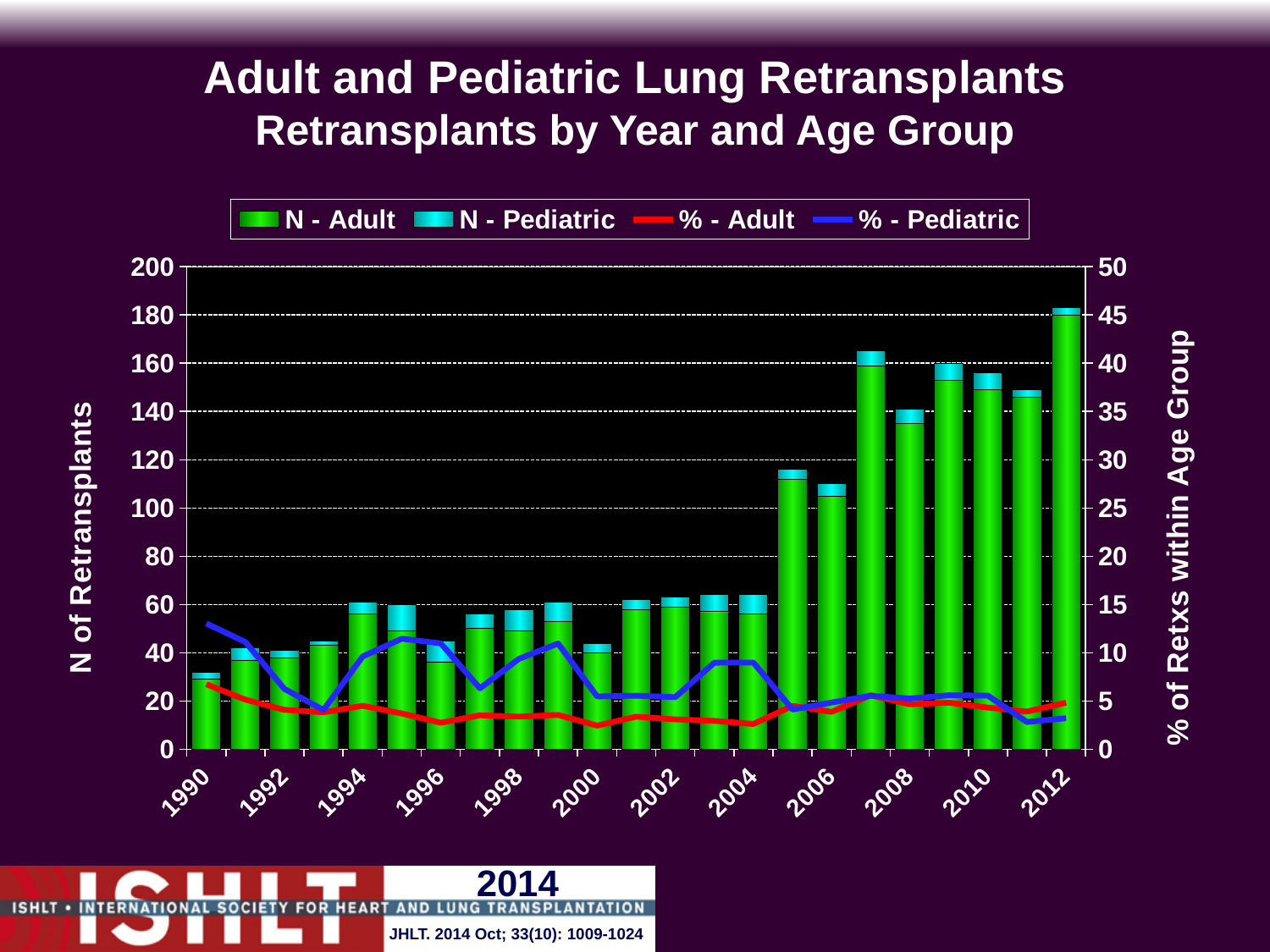
Overall, do the bar heights rise or fall from 1990 to 2012? rise What type of chart is shown on the slide? A combined bar and line chart (stacked bars with two lines) Which year has the shortest bar for number of retransplants? 1990 What is the label of the right-hand vertical axis? % of Retxs within Age Group Is the total number of retransplants in 1990 greater or less than 40? less Is the total number of retransplants in 2012 greater or less than 160? greater How many series does the legend list? 4 Is the % - Pediatric value in 1990 greater or less than 10 on the right axis? greater Which year has the tallest bar for number of retransplants? 2012 How many years (bars) are plotted on the chart? 23 Which year has the taller bar, 2007 or 2008? 2007